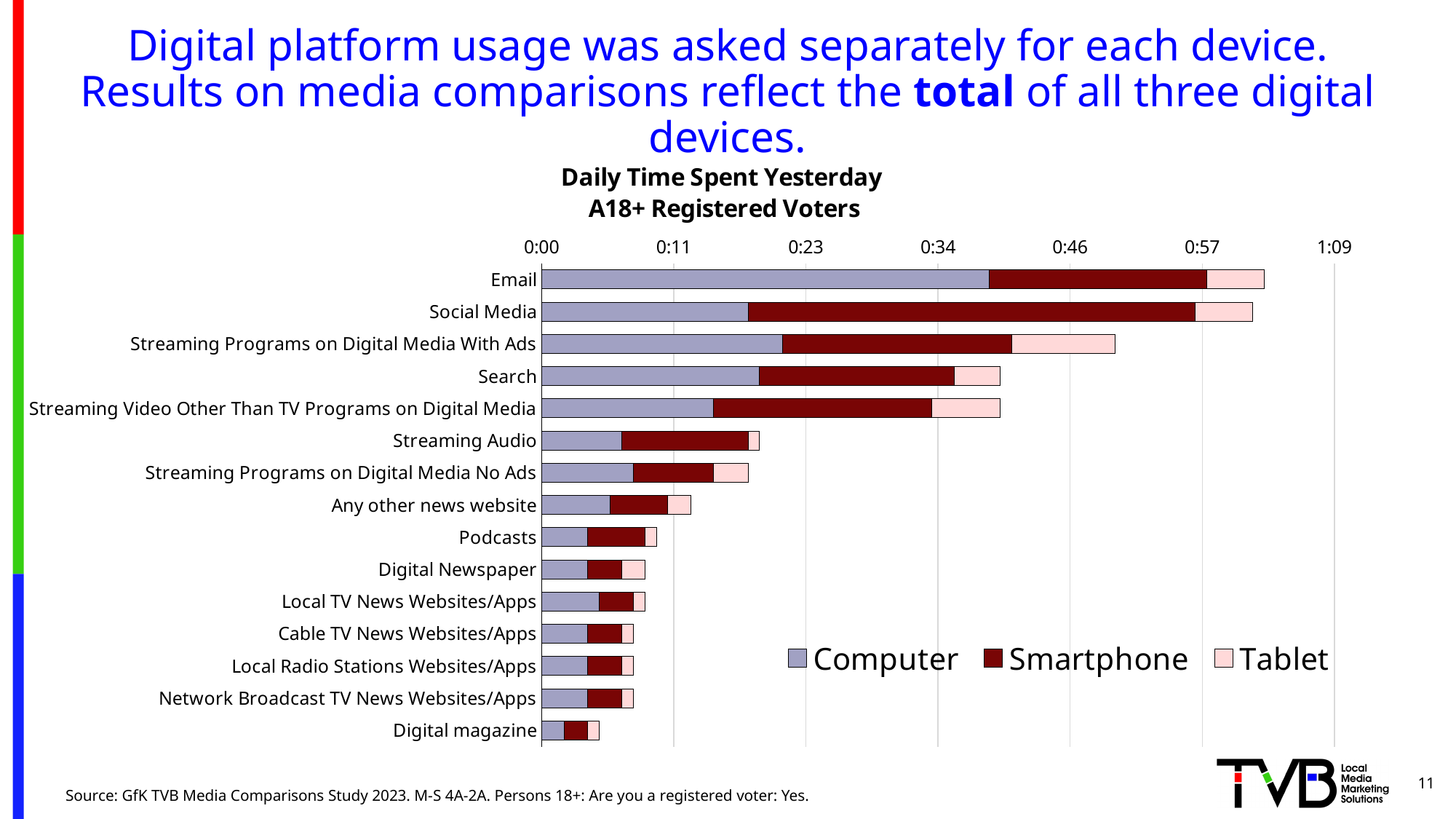
Is the total bar for Search greater or less than 0:34? greater Which has a longer total bar, Search or Streaming Audio? Search Do the total bar lengths generally rise or fall going down the list of categories from Email to Digital magazine? fall Is the total bar for Streaming Audio greater or less than 0:23? less Which has a longer Computer segment, Email or Social Media? Email Is the total bar for Email greater or less than 0:57? greater Which series is shown in dark red in the legend? Smartphone Which category has the shortest total bar? Digital magazine How many categories are plotted in the Daily Time Spent Yesterday chart? 15 How many series does the legend list? 3 What kind of chart is shown on the slide? Stacked bar chart